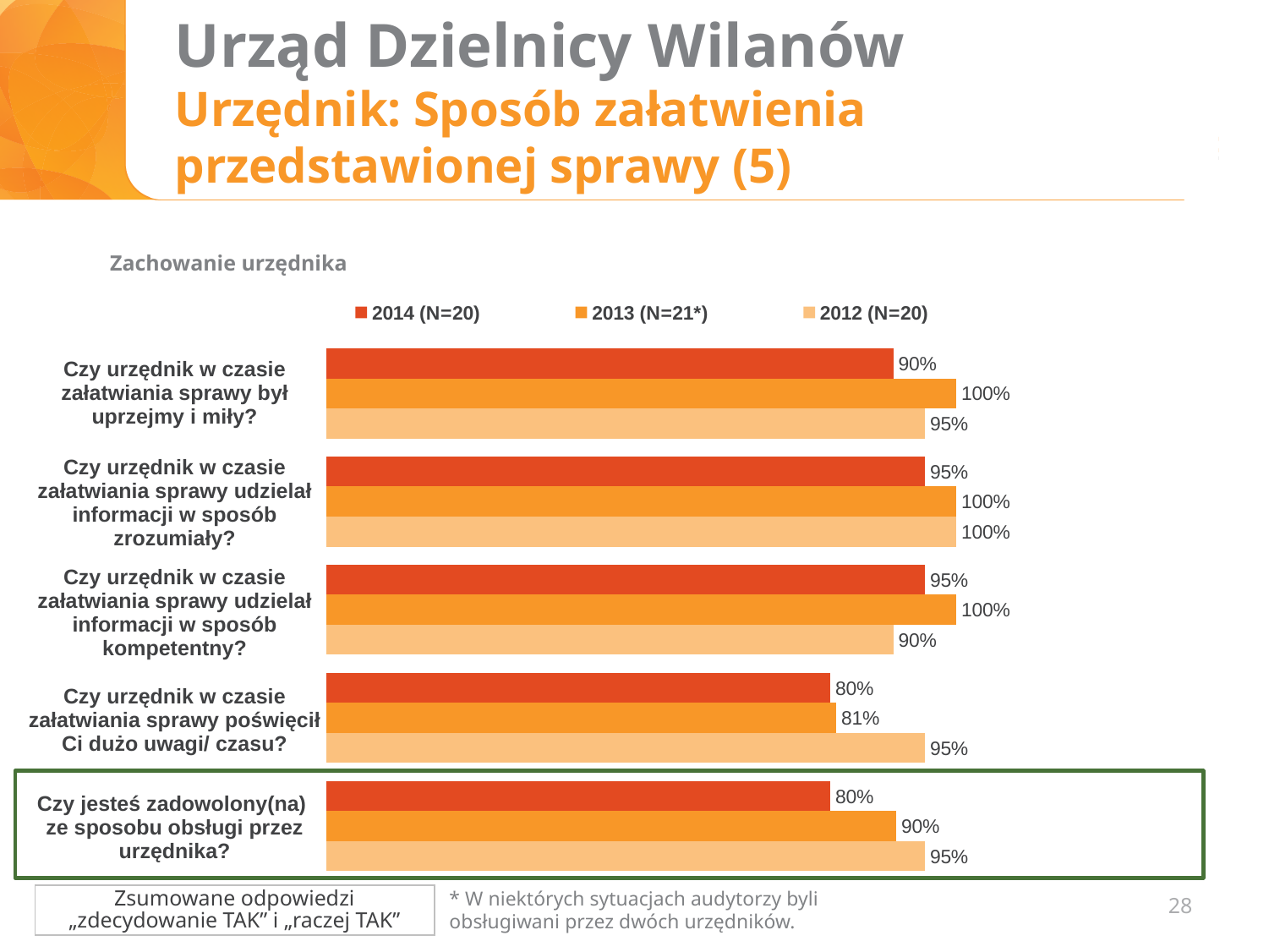
Which series is shown in the darkest (red-orange) colour in the legend? 2014 (N=20) How many question categories are plotted on the chart? 5 What type of chart is shown on the slide? bar chart For "Czy urzędnik w czasie załatwiania sprawy udzielał informacji w sposób kompetentny?", which is larger: the 2013 (N=21*) value or the 2012 (N=20) value? 2013 (N=21*) What is the 2013 (N=21*) value for "Czy urzędnik w czasie załatwiania sprawy poświęcił Ci dużo uwagi/ czasu?"? 81% What is the difference between the 2013 (N=21*) and 2014 (N=20) values for "Czy urzędnik w czasie załatwiania sprawy był uprzejmy i miły?"? 10 percentage points What is the 2012 (N=20) value for "Czy jesteś zadowolony(na) ze sposobu obsługi przez urzędnika?"? 95% How many series does the chart legend list? 3 What is the title shown above the chart? Zachowanie urzędnika What is the difference between the 2012 (N=20) and 2014 (N=20) values for "Czy jesteś zadowolony(na) ze sposobu obsługi przez urzędnika?"? 15 percentage points What is the 2014 (N=20) value for "Czy urzędnik w czasie załatwiania sprawy był uprzejmy i miły?"? 90% Which category has the lowest 2014 (N=20) value? Czy urzędnik w czasie załatwiania sprawy poświęcił Ci dużo uwagi/ czasu? and Czy jesteś zadowolony(na) ze sposobu obsługi przez urzędnika? (both 80%)